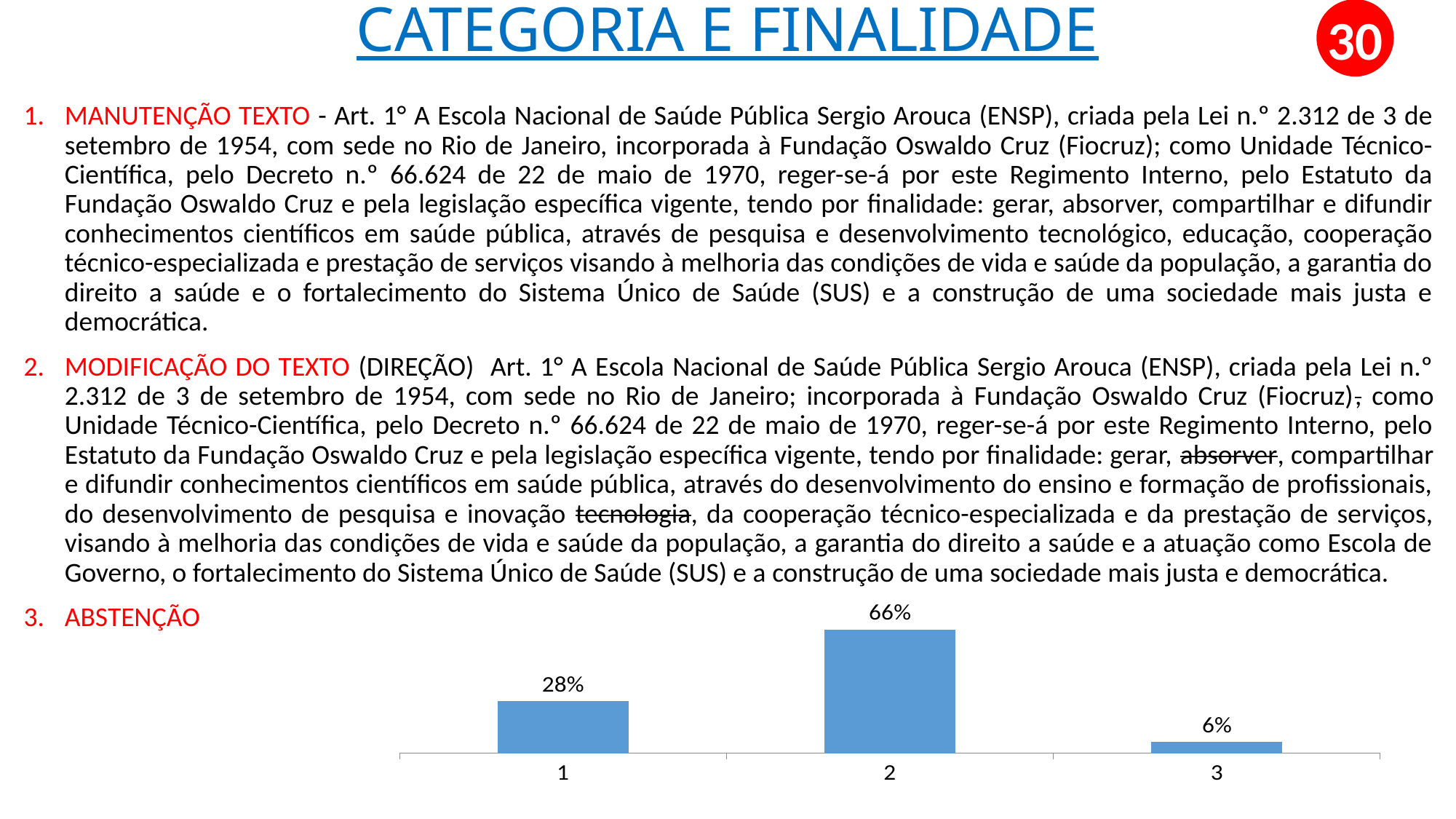
Which is larger, the value for category 1 or the value for category 3? Category 1 What is the value for category 1 in the bar chart? 28% What kind of chart is shown on the slide? Bar chart What is the total of the three values shown in the bar chart? 100% What is the difference between the values for category 1 and category 3? 22% What is the difference between the values for category 2 and category 1? 38% What is the value for category 2 in the bar chart? 66% Which category has the highest value in the bar chart? 2 How many categories are shown in the bar chart? 3 Which category has the lowest value in the bar chart? 3 What is the value for category 3 in the bar chart? 6% What colour are the bars in the chart? Blue